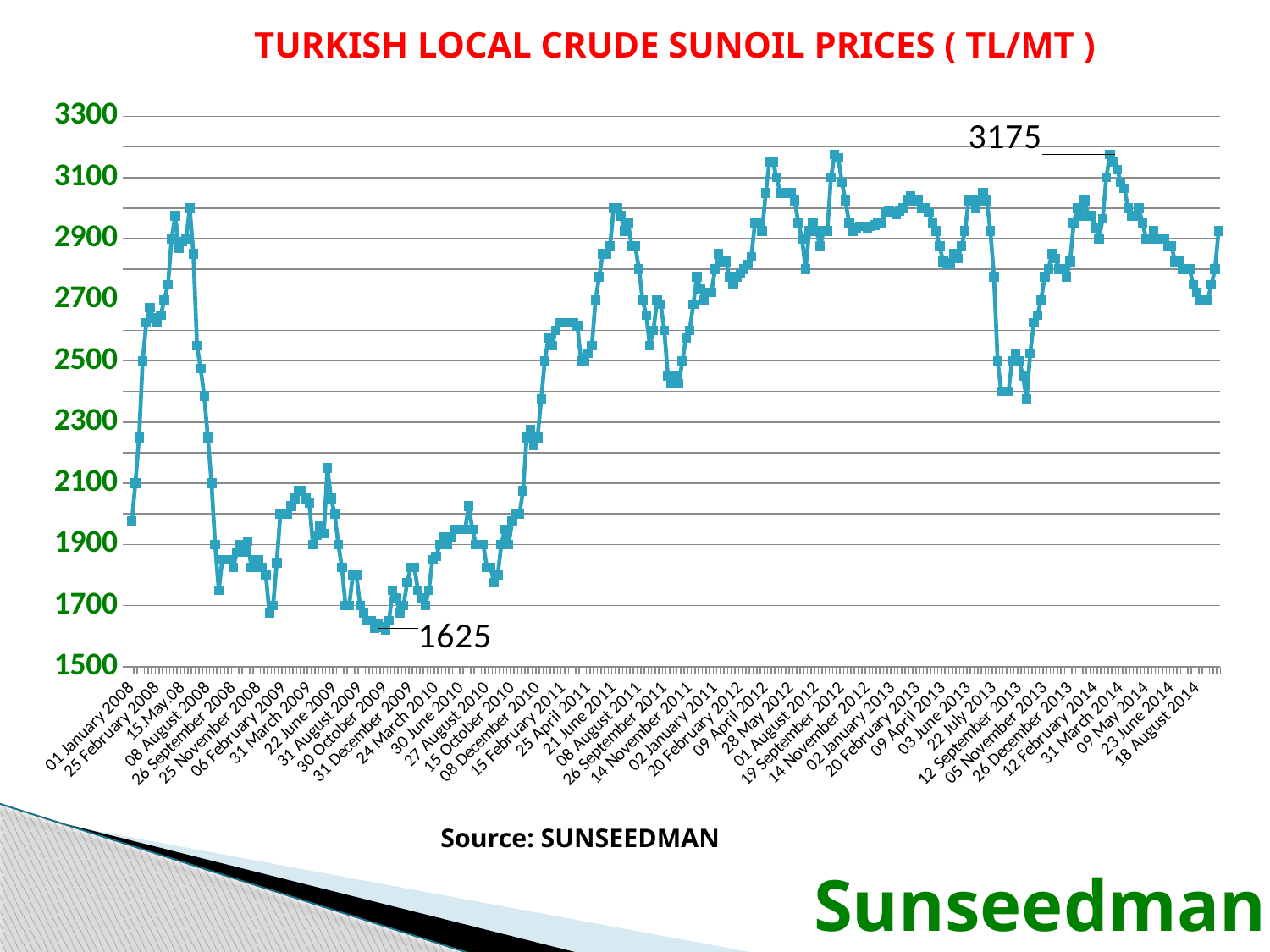
How many data series are plotted on the chart? 1 What is the highest price labelled on the chart? 3175 What is the title of the chart? TURKISH LOCAL CRUDE SUNOIL PRICES ( TL/MT ) What source is cited below the chart? SUNSEEDMAN Do prices rise or fall between 15 May 08 and 26 September 2008? fall What is the lowest price labelled on the chart? 1625 What is the difference between the highest labelled price (3175) and the lowest labelled price (1625)? 1550 What kind of chart is shown on the slide? line chart Do prices rise or fall between 31 December 2009 and 15 February 2011? rise Which is higher, the price around 15 May 08 or the price around 31 December 2009? 15 May 08 Is the price at 01 January 2008 greater or less than 2100? less